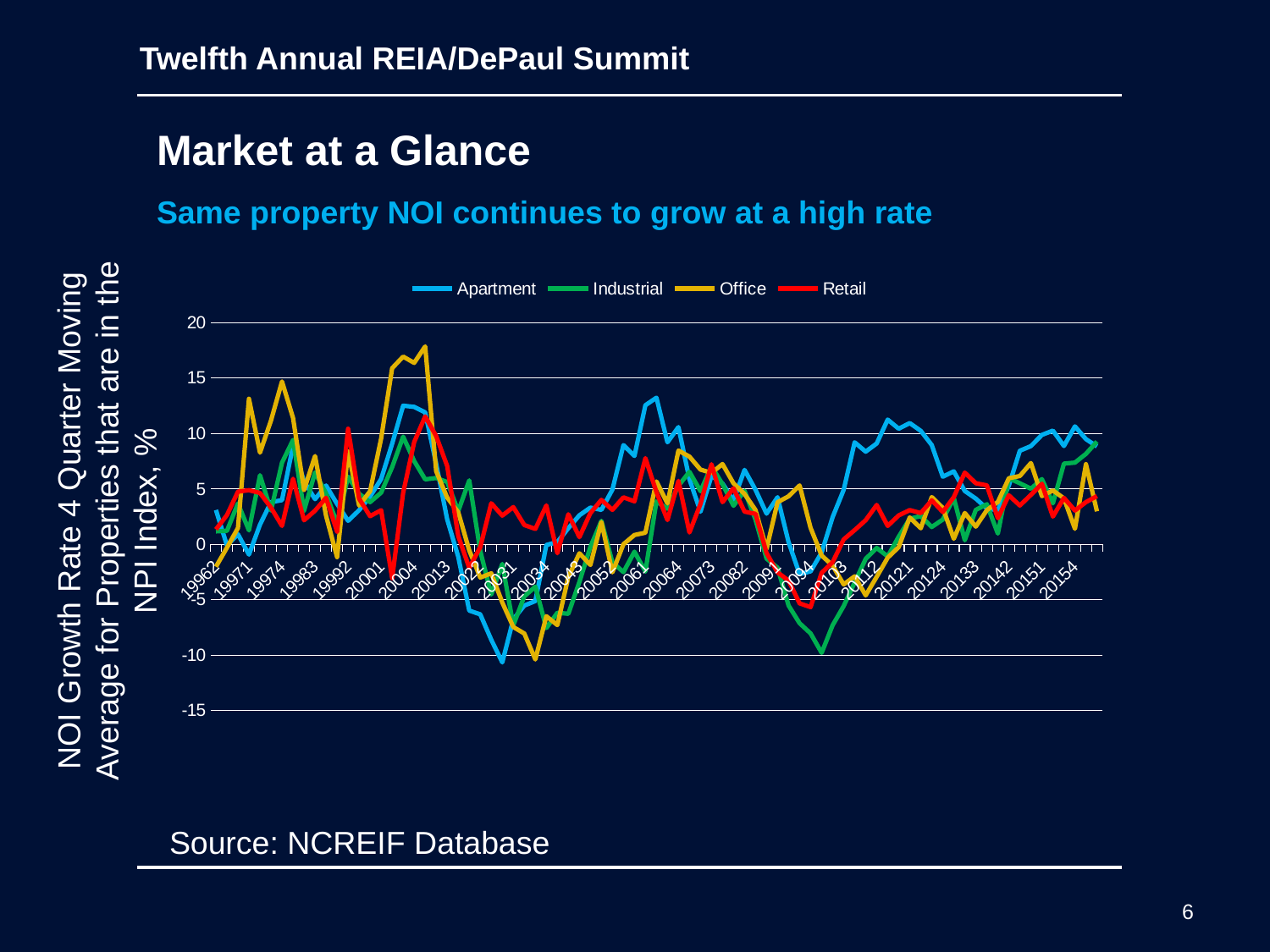
What kind of chart is shown on the slide? line chart Which series reaches the highest peak on the chart? Office Is the value of the Apartment series around 20031 greater or less than -5? less Is the peak value of the Office series around 20004 greater or less than 15? greater How many series does the legend list? 4 Is the value of the Apartment series around 20061 greater or less than 10? greater What is the label of the vertical axis of the chart? NOI Growth Rate 4 Quarter Moving Average for Properties that are in the NPI Index, % What is the highest value shown on the vertical axis? 20 What is the lowest value shown on the vertical axis? -15 Which series are listed in the chart legend? Apartment, Industrial, Office, Retail